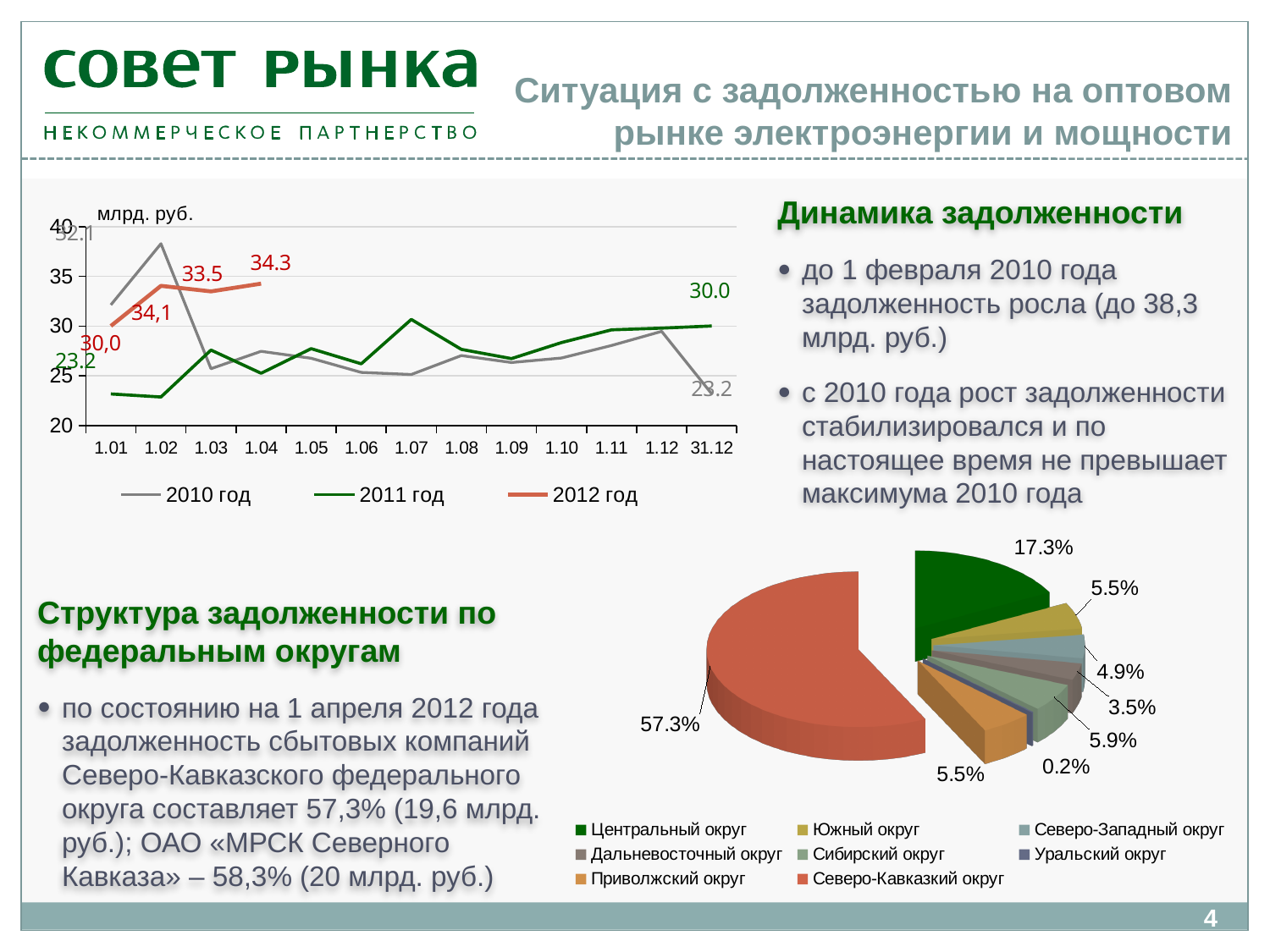
In the bottom-right pie chart, how many districts does the legend list? 8 In the top-left line chart, what is the value for 2011 год at 31.12? 30.0 In the top-left line chart, what is the difference between the 2012 год values at 1.04 and 1.03? 0.8 What kind of chart is the top-left chart with the 'млрд. руб.' axis? line chart In the bottom-right pie chart, which district has the smallest slice? Уральский округ In the top-left line chart, how many points are labelled on the x axis? 13 In the top-left line chart, what is the value for 2012 год at 1.02? 34,1 In the top-left line chart, how many series does the legend list? 3 In the bottom-right pie chart, what share does Центральный округ have? 17.3% In the bottom-right pie chart, what share does Северо-Кавказкий округ have? 57.3% In the top-left line chart, is the value for 2010 год at 1.02 greater or less than 35? greater In the top-left line chart, what is the value for 2012 год at 1.04? 34.3